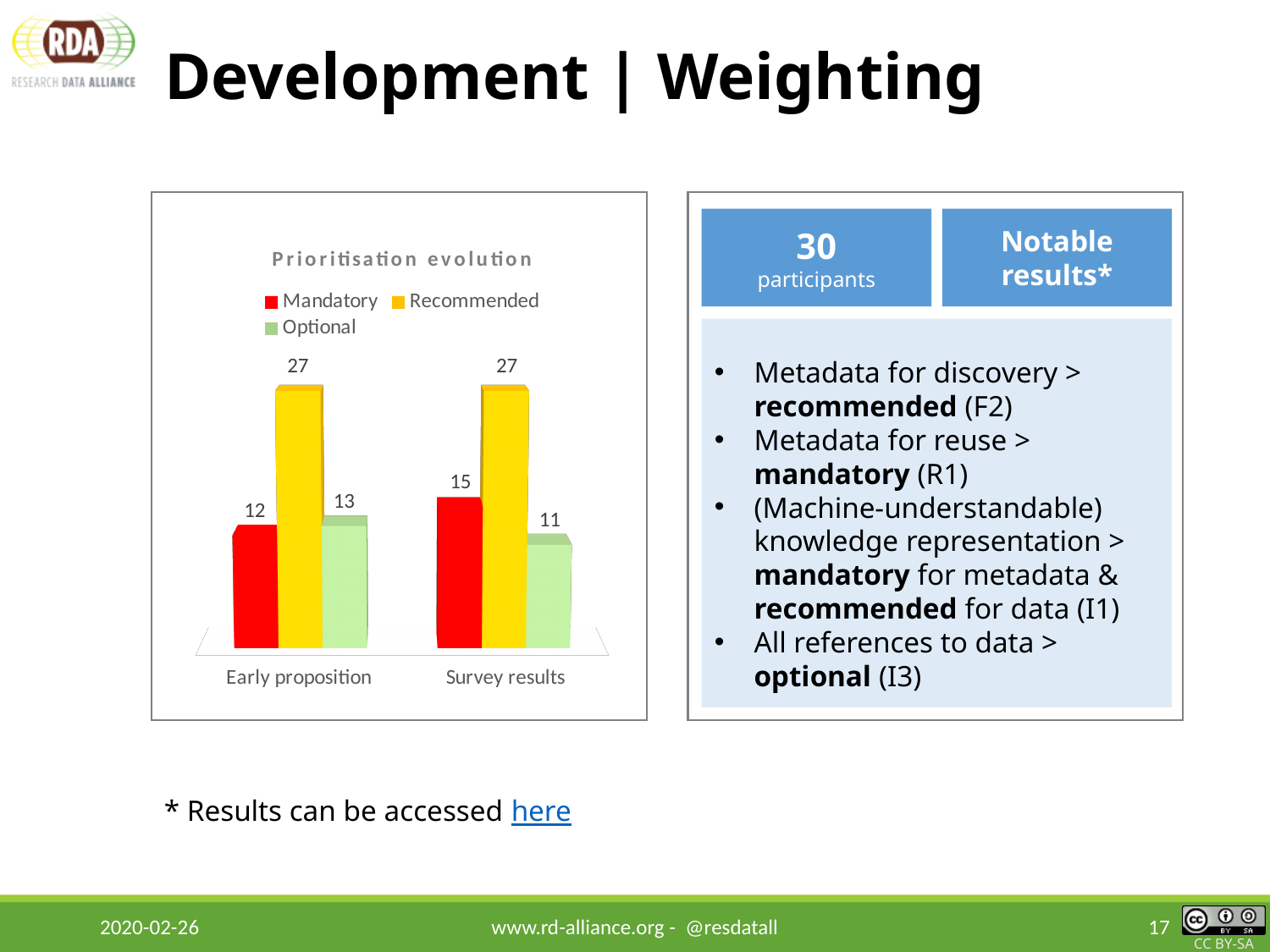
What is the value for Optional in the Early proposition category? 13 What is the difference between the Mandatory values for Survey results and Early proposition? 3 What is the value for Recommended in the Survey results category? 27 What kind of chart is shown on the slide? Bar chart How many categories are shown on the x axis? 2 Which is larger: Optional in Early proposition or Optional in Survey results? Optional in Early proposition What is the title of the chart? Prioritisation evolution What is the value for Optional in the Survey results category? 11 Which series has the highest value in the Survey results category? Recommended How many series does the legend list? 3 Which series has the lowest value in the Early proposition category? Mandatory What is the value for Mandatory in the Early proposition category? 12